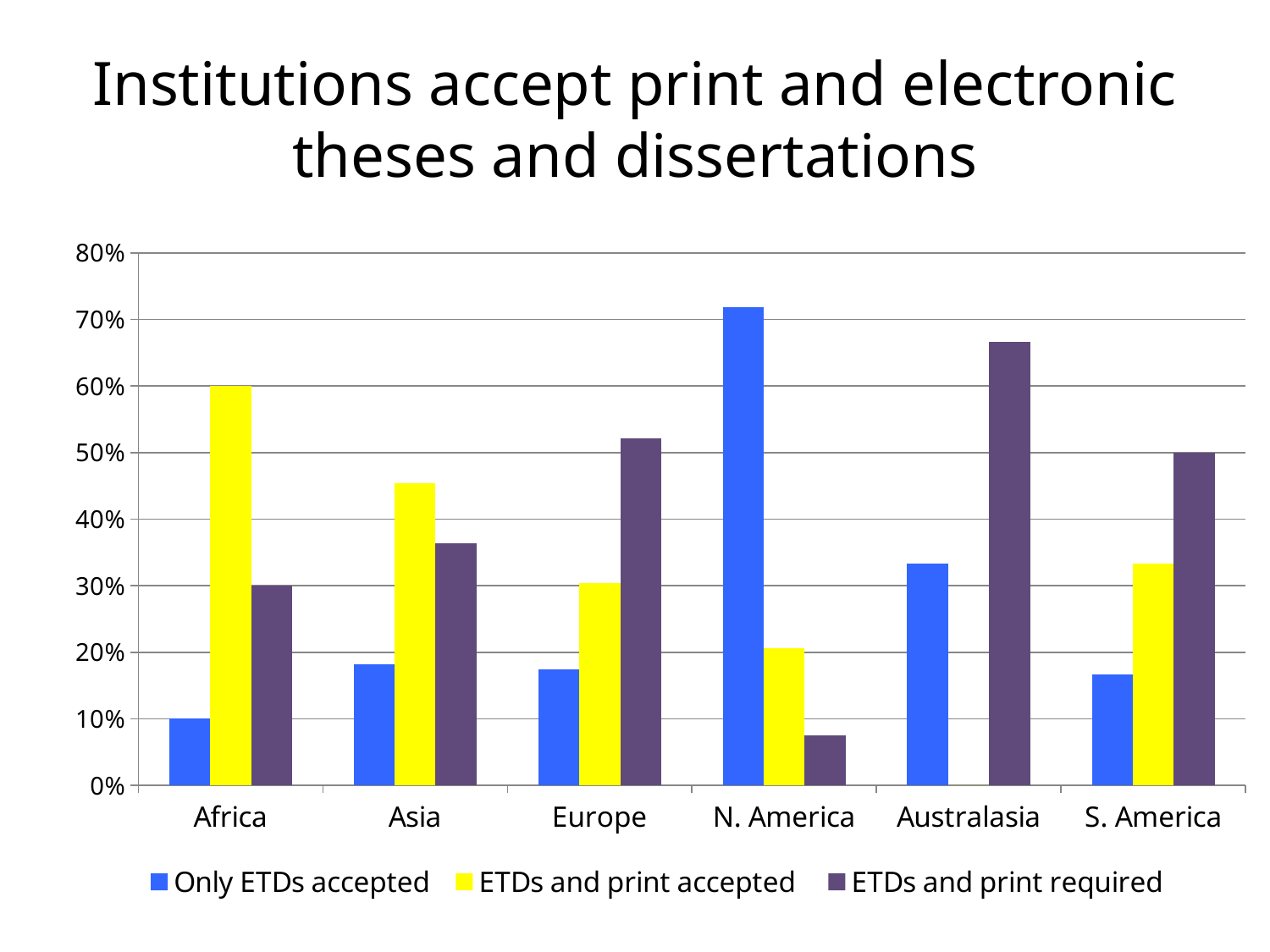
What colour represents the 'ETDs and print accepted' series? yellow How many regions are shown on the x axis? 6 Is the value for 'Only ETDs accepted' in N. America greater or less than 60%? greater Which region has the highest value for 'Only ETDs accepted'? N. America Which region has the lowest value for 'ETDs and print accepted'? Australasia Is the value for 'ETDs and print required' in N. America greater or less than 10%? less How many series does the legend list? 3 What is the value for 'ETDs and print required' in S. America? 50% What kind of chart is shown on the slide? bar chart Which region has the highest value for 'ETDs and print required'? Australasia What is the value for 'ETDs and print accepted' in Africa? 60% In Africa, which is larger: 'ETDs and print accepted' or 'ETDs and print required'? ETDs and print accepted